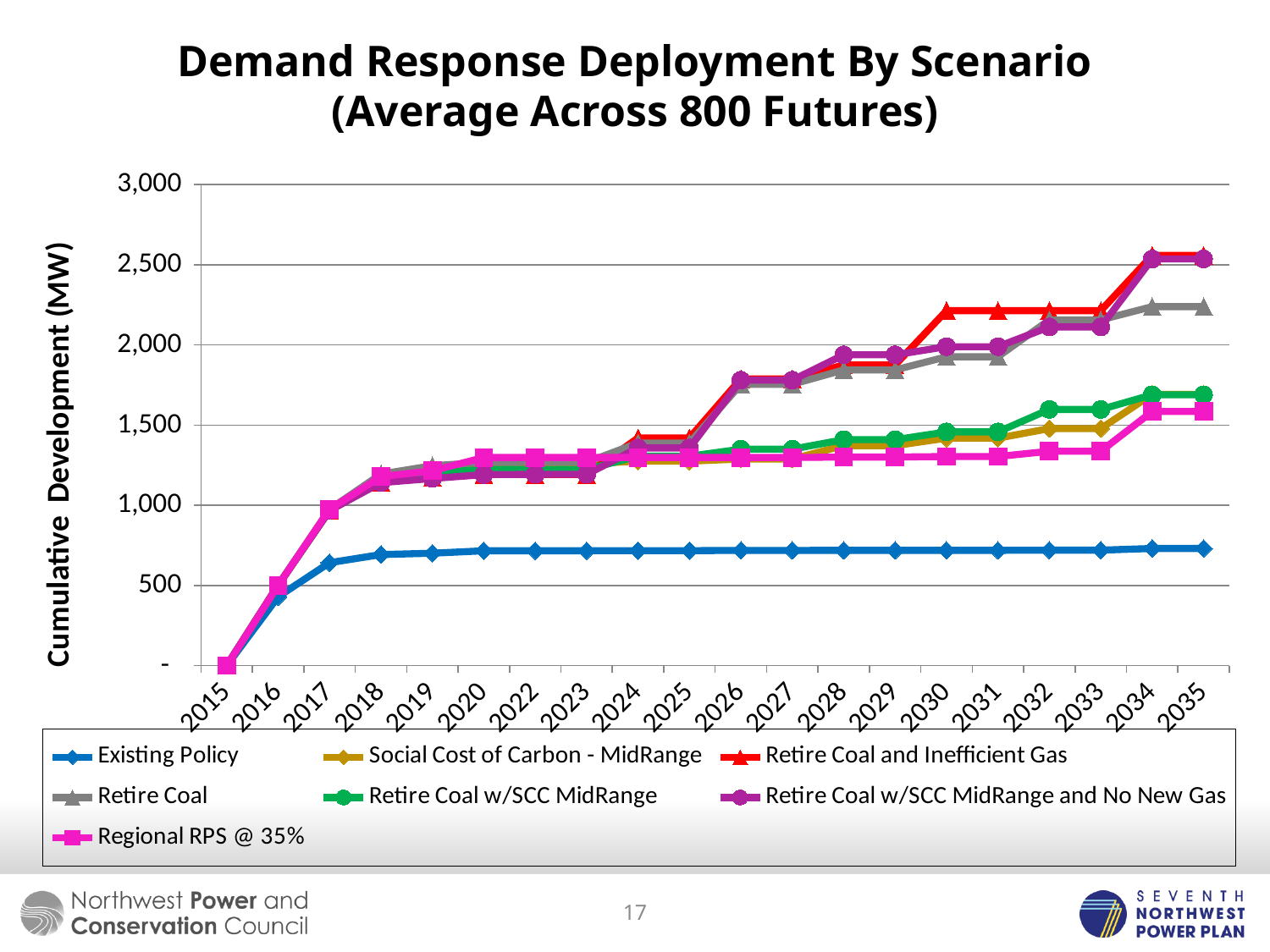
Is the value for Retire Coal and Inefficient Gas in 2035 greater or less than 2,000? greater How many years are plotted along the x axis? 20 Which scenario has the lowest cumulative development in 2035? Existing Policy Does the Existing Policy line rise or fall from 2015 to 2018? rise What colour is the line for Retire Coal and Inefficient Gas? red Is the value for Regional RPS @ 35% in 2030 greater or less than 1,500? less Is the value for Existing Policy in 2035 greater or less than 1,000? less How many series does the legend list? 7 What kind of chart is shown on the slide? line chart In 2035, which is larger: Retire Coal or Regional RPS @ 35%? Retire Coal What is the title of the y axis? Cumulative Development (MW)